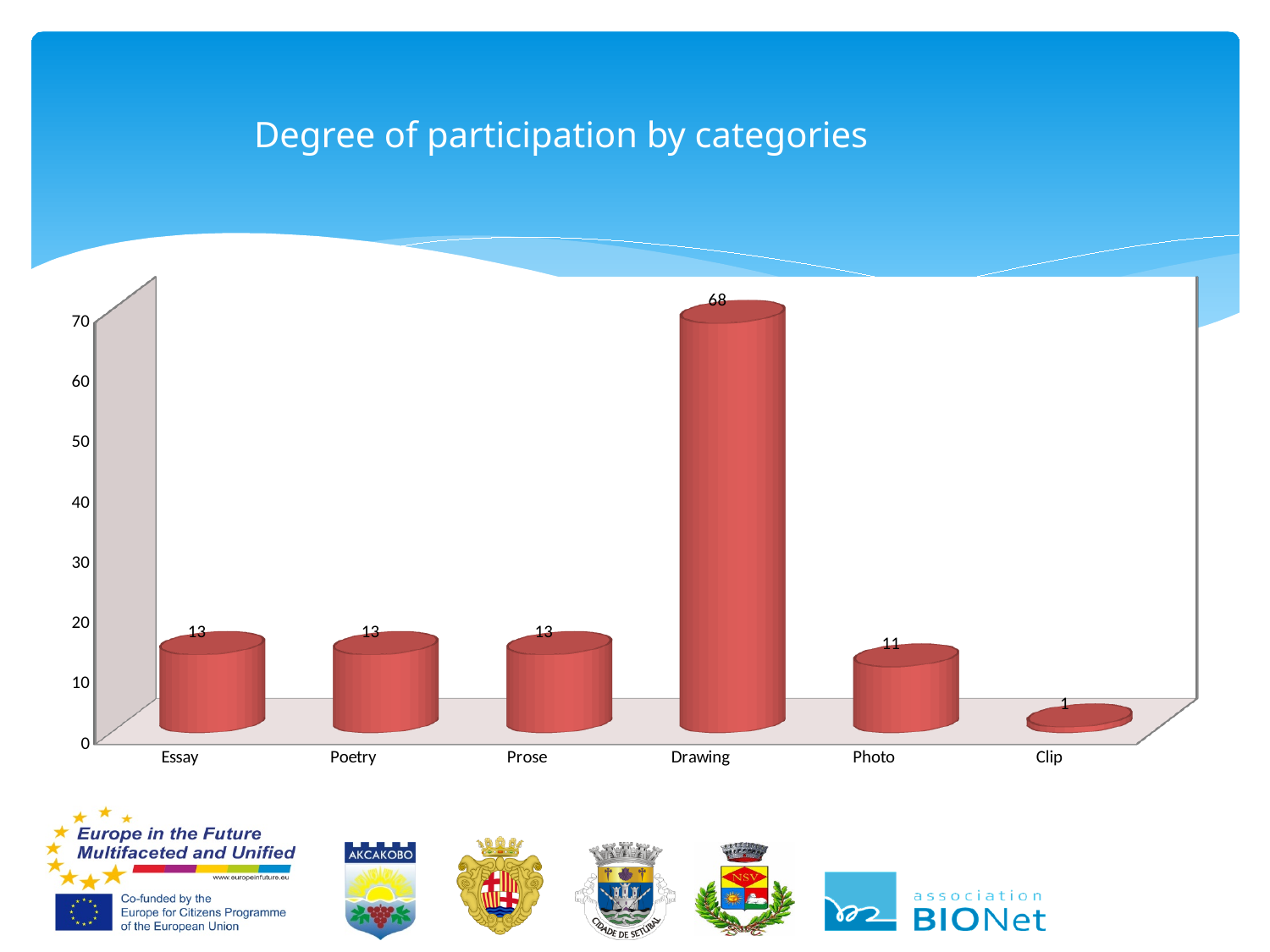
What is the title of the chart? Degree of participation by categories Which category has the lowest value? Clip What is the difference between the values for Poetry and Clip? 12 What is the value for Drawing? 68 What is the value for Clip? 1 Which category has the highest value? Drawing Which is larger, the value for Prose or the value for Photo? Prose What kind of chart is shown on the slide? bar chart What is the value for Photo? 11 How many categories are shown on the x axis? 6 What is the value for Essay? 13 What is the difference between the values for Drawing and Photo? 57